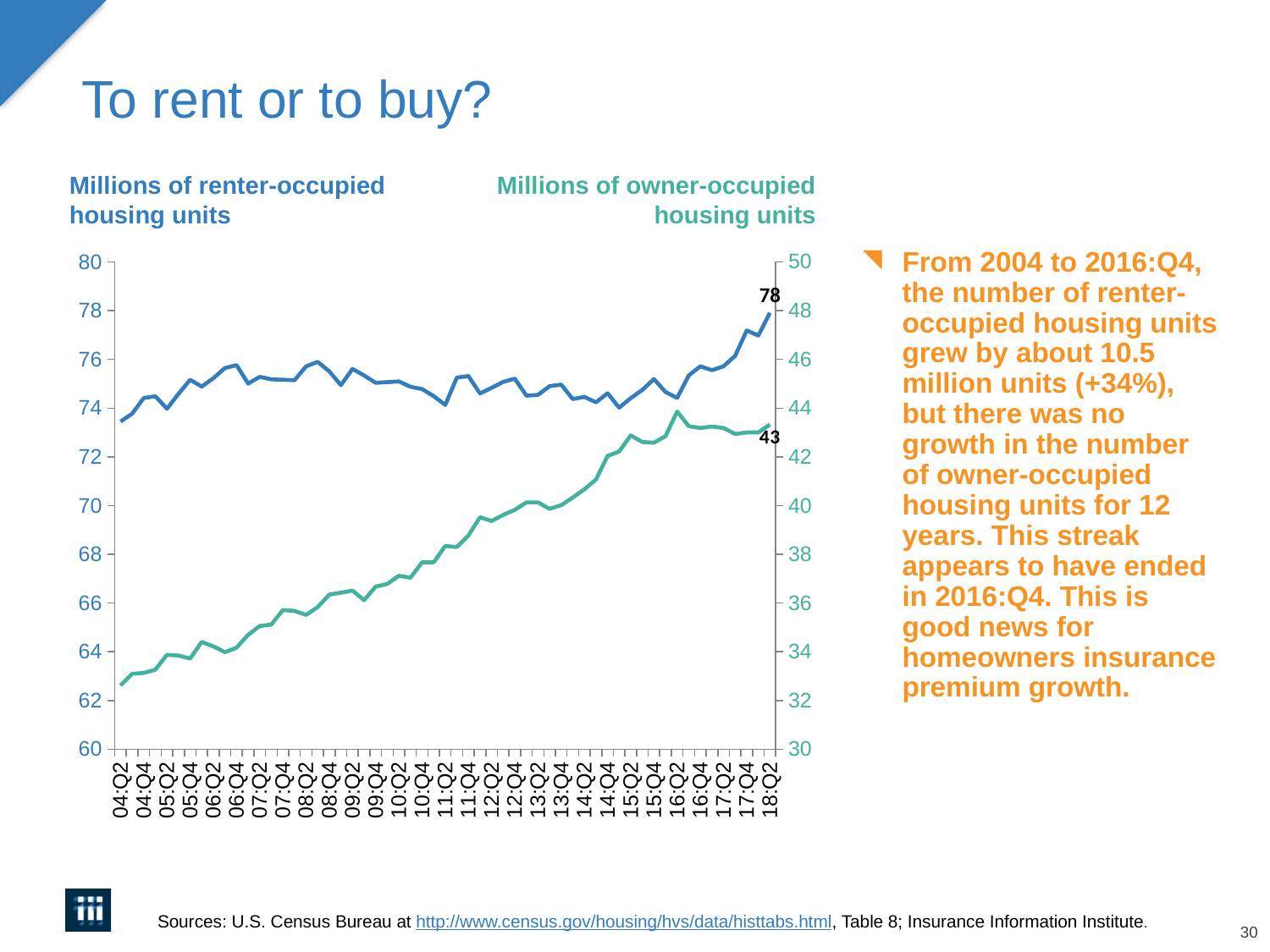
How many data series are plotted on the chart? 2 Does the green line generally rise or fall from 04:Q2 to 18:Q2? rise What value is labelled at the end of the green line (18:Q2)? 43 What value is labelled at the end of the blue line (18:Q2)? 78 What is the difference between the two labelled end values, 78 and 43? 35 On the right axis, is the green line's value at 04:Q2 greater or less than 34? less What is the first label on the x axis? 04:Q2 What kind of chart is shown on the slide? line chart On the left axis, is the blue line's value at 04:Q2 greater or less than 72? greater What is the highest tick value shown on the left axis? 80 On the right axis, is the green line's value at 16:Q2 greater or less than 42? greater